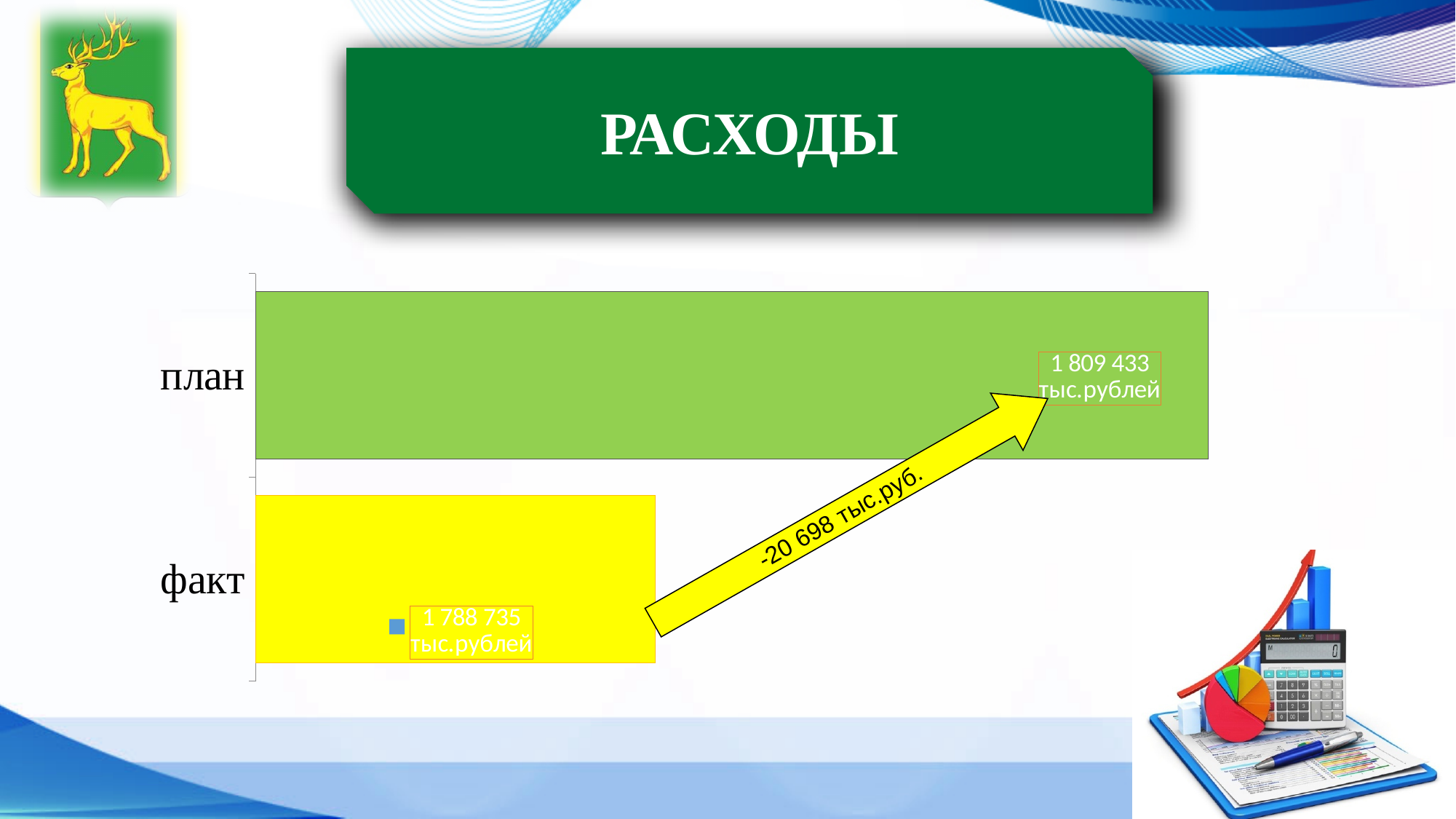
What kind of chart is shown on the slide? bar chart What is the title shown above the chart? РАСХОДЫ What is the value shown for план? 1 809 433 тыс.рублей What value is written on the arrow between the two bars? -20 698 тыс.руб. Is the value for факт greater or less than the value for план? less What is the value shown for факт? 1 788 735 тыс.рублей What is the difference between the план value and the факт value? 20 698 тыс.рублей Which category has the higher value, план or факт? план Which category has the highest value? план How many categories are shown in the chart? 2 Which category has the lowest value? факт